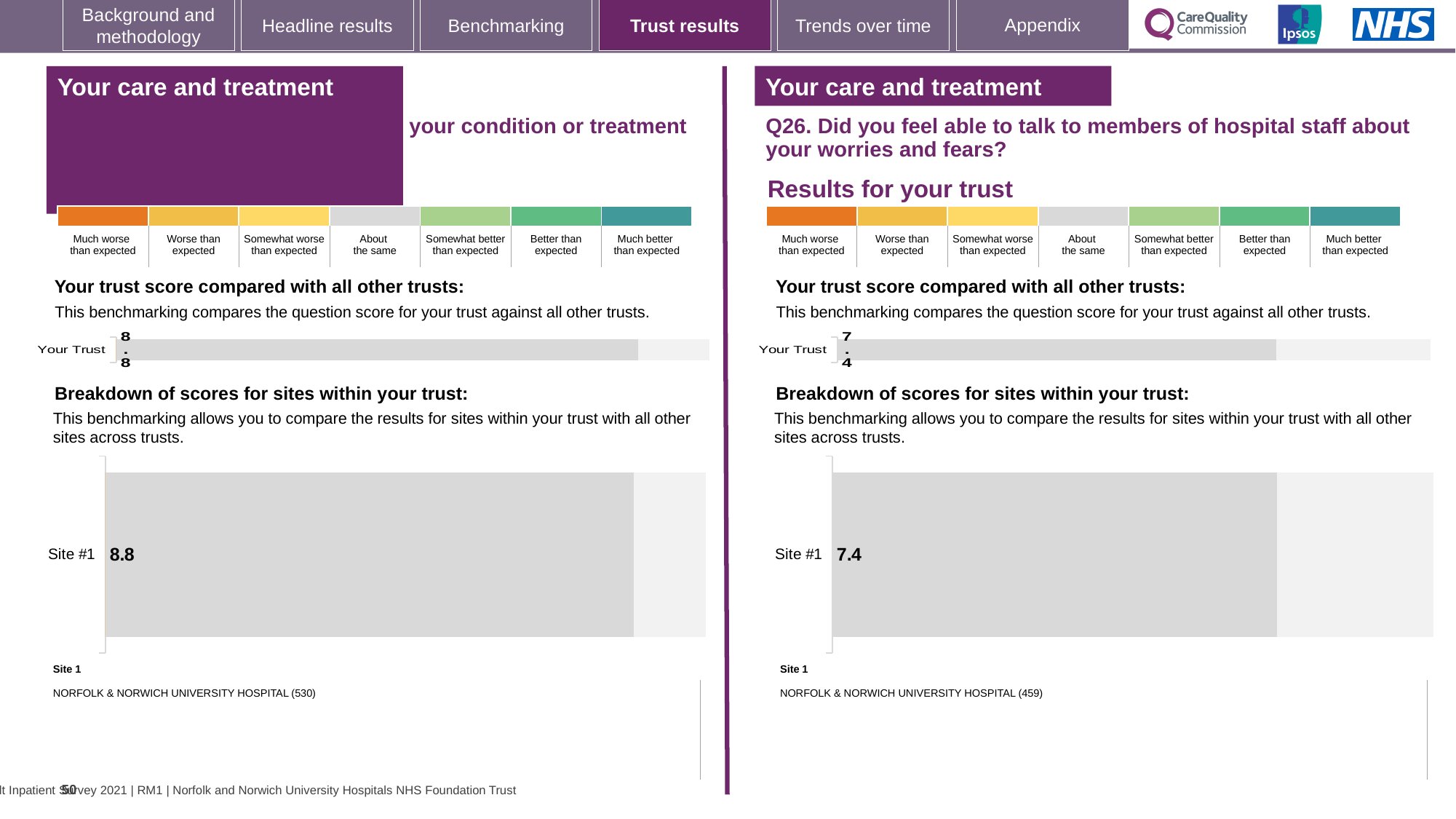
On the left-hand chart, is the Site #1 score the same as the Your Trust score? Yes, both are 8.8 What type of chart is used to show the Your Trust score on each side of the slide? Bar chart On the right-hand Q26 breakdown of scores for sites chart, what is the score for Site #1? 7.4 What is the difference between the Site #1 score on the left-hand chart and the Site #1 score on the right-hand Q26 chart? 1.4 Which is higher: the Your Trust score on the left-hand chart or the Your Trust score on the right-hand Q26 chart? The left-hand chart (8.8) What question number is shown above the right-hand charts? Q26 How many sites are shown in the right-hand Q26 breakdown of scores for sites chart? 1 On the left-hand chart, what is the score shown for Your Trust? 8.8 Which hospital is listed as Site 1 beneath the left-hand breakdown chart? NORFOLK & NORWICH UNIVERSITY HOSPITAL (530) On the right-hand Q26 chart, is the Your Trust score greater or less than 8? less On the left-hand breakdown of scores for sites chart, what is the score for Site #1? 8.8 On the right-hand chart for Q26, what is the score shown for Your Trust? 7.4